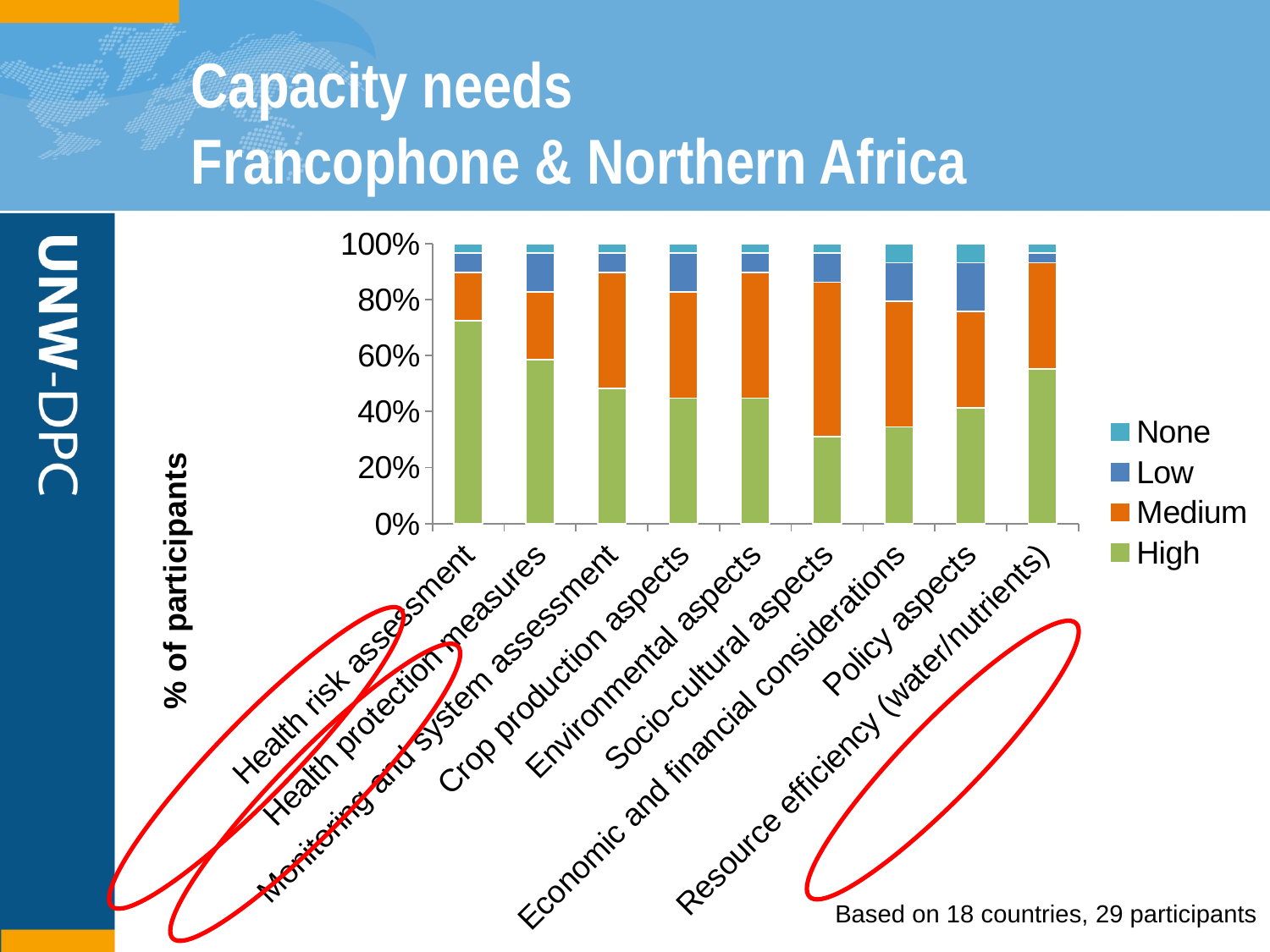
Is the High value for Health risk assessment greater or less than 60%? greater What kind of chart is shown on the slide? Stacked bar chart Which has a larger High segment, Health risk assessment or Crop production aspects? Health risk assessment Is the High value for Resource efficiency (water/nutrients) greater or less than 40%? greater What is the label on the y axis? % of participants How many series does the legend list? 4 Which category has the largest Medium segment? Socio-cultural aspects How many categories are plotted along the x axis? 9 What does each stacked bar total? 100% Which legend entry is shown in green? High Is the High value for Socio-cultural aspects greater or less than 40%? less Which category has the largest High segment? Health risk assessment